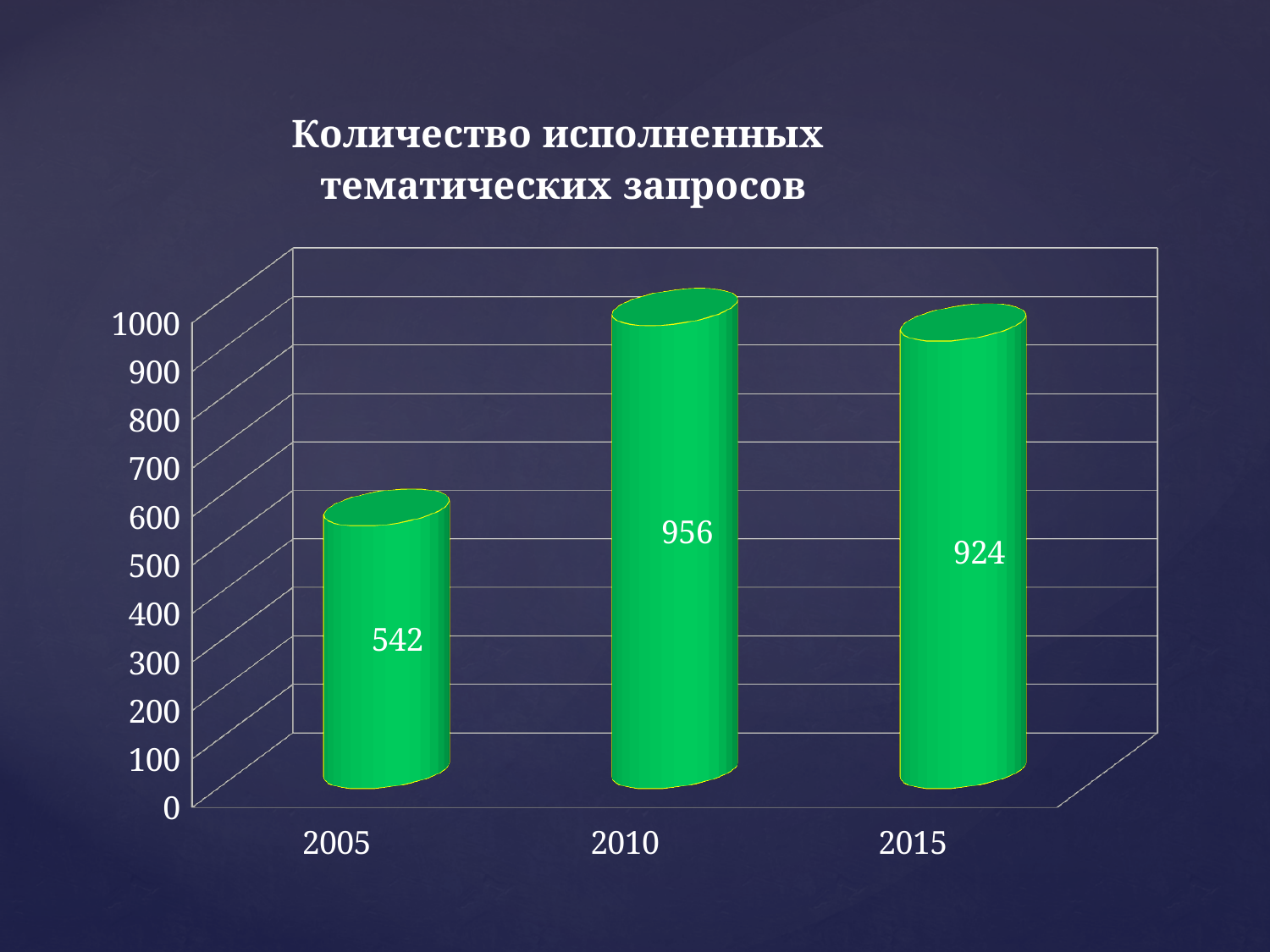
What is the value for 2010? 956 What is the difference between the values for 2010 and 2005? 414 What kind of chart is this? bar chart What is the difference between the values for 2010 and 2015? 32 Which is larger, the value for 2015 or the value for 2005? 2015 Is the value for 2005 greater or less than 600? less How many years are shown on the x axis? 3 Which year has the highest value? 2010 What is the value for 2005? 542 Which year has the lowest value? 2005 What is the title of the chart? Количество исполненных тематических запросов What is the value for 2015? 924